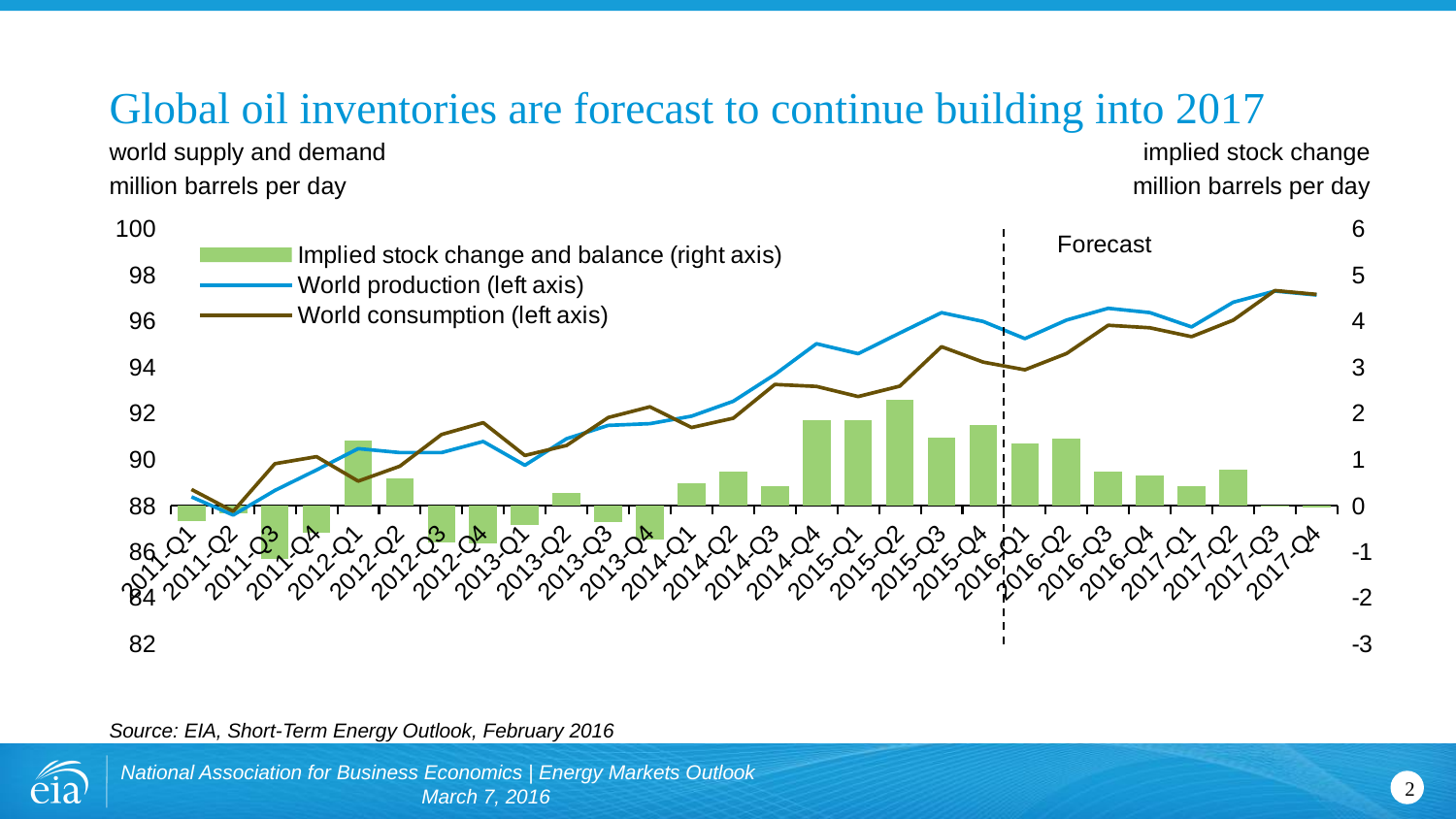
Does world consumption generally rise or fall from 2011-Q1 to 2017-Q4? rise Is the implied stock change for 2011-Q3 greater or less than 0? less Is world production in 2017-Q3 greater or less than 96? greater What kind of chart is shown on the slide? A combination bar and line chart In which quarter does the forecast period begin, according to the dashed line? 2016-Q1 Which series is plotted as bars? Implied stock change and balance (right axis) In which quarter is the implied stock change bar the tallest? 2015-Q2 How many series does the legend list? 3 How many quarters are shown along the x axis? 28 Is world consumption in 2011-Q2 greater or less than 90? less In 2015-Q3, which is higher: world production or world consumption? World production